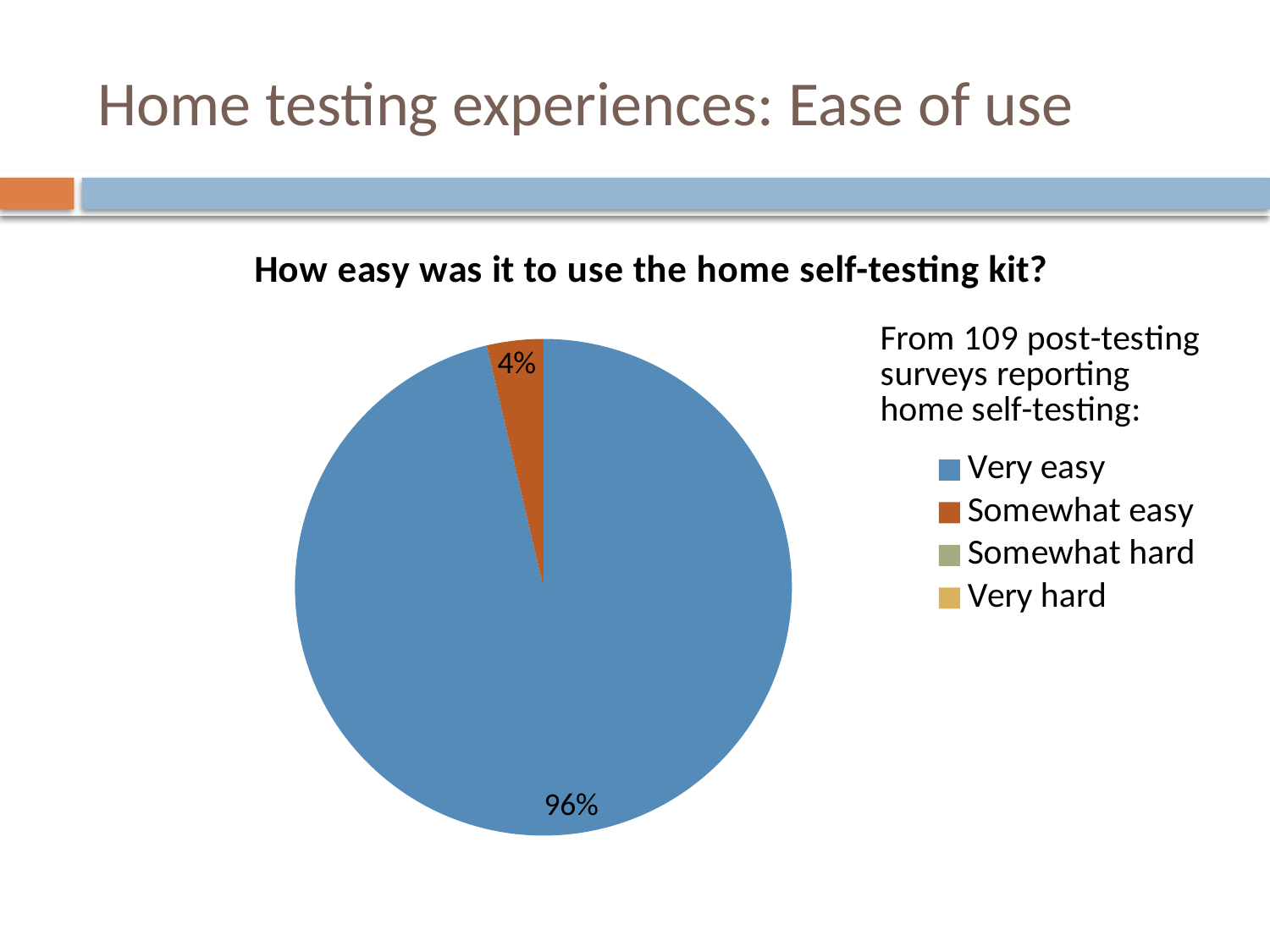
Which category has the largest slice of the pie? Very easy What is the difference in percentage points between the Very easy and Somewhat easy slices? 92 What share of the pie is labelled for Somewhat easy? 4% How many post-testing surveys does the slide say the chart is based on? 109 How many categories does the legend list? 4 What kind of chart is shown on the slide? pie chart What is the title of the chart? How easy was it to use the home self-testing kit? What share of the pie is labelled for Very easy? 96% What colour is the Very easy slice? blue Which is larger, the Very easy slice or the Somewhat easy slice? Very easy